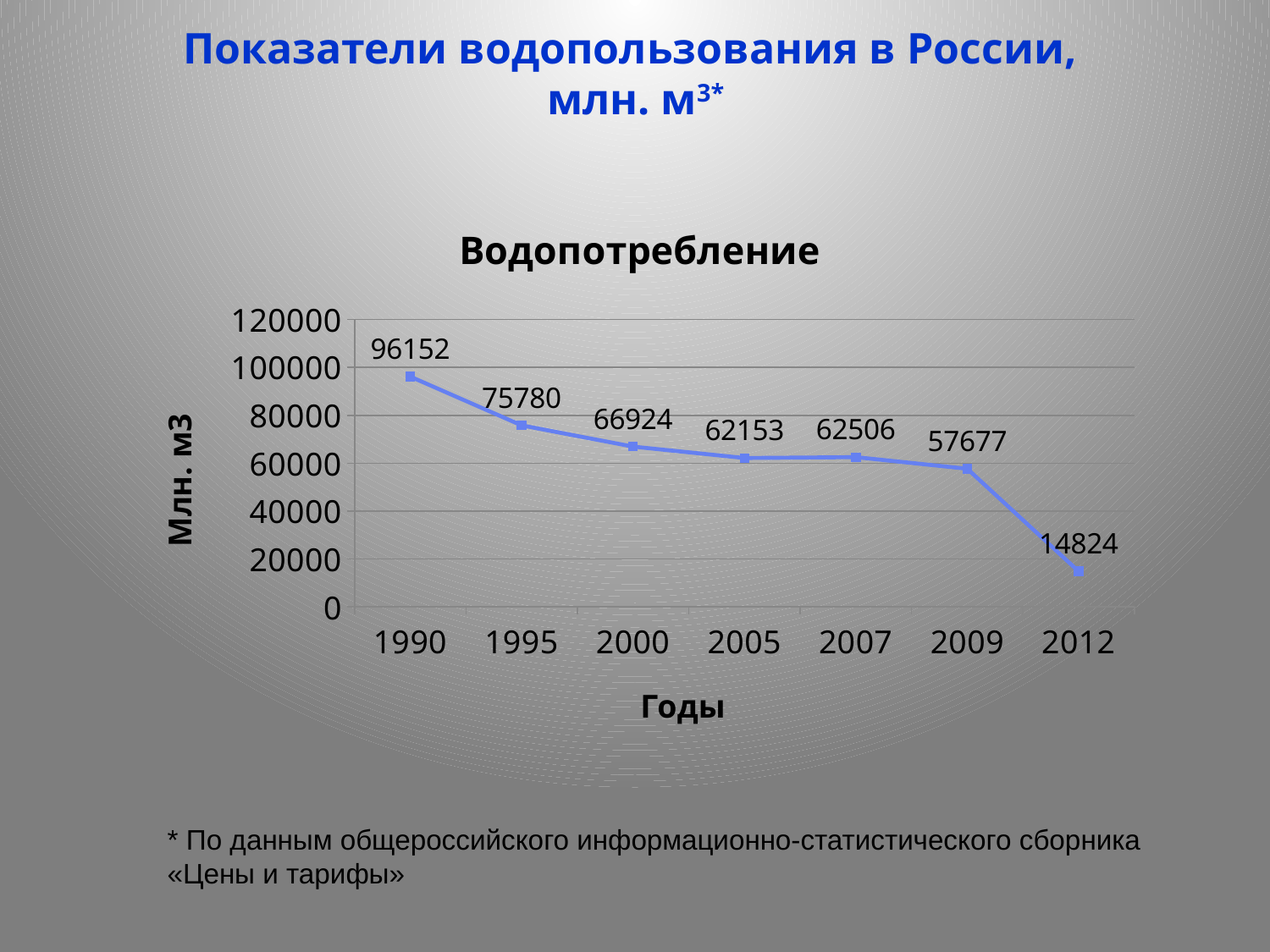
What is the water consumption value for 2012? 14824 Do the values generally rise or fall from 1990 to 2012? fall Which is larger, the value for 2005 or the value for 2007? 2007 What is the difference between the values for 1990 and 1995? 20372 How many years are plotted on the chart? 7 Which year has the highest water consumption? 1990 What is the difference between the values for 2009 and 2012? 42853 What kind of chart is shown on the slide? line chart What is the water consumption value for 1990? 96152 Is the value for 2000 greater or less than 60000? greater Which year has the lowest water consumption? 2012 What is the value plotted for 2005? 62153